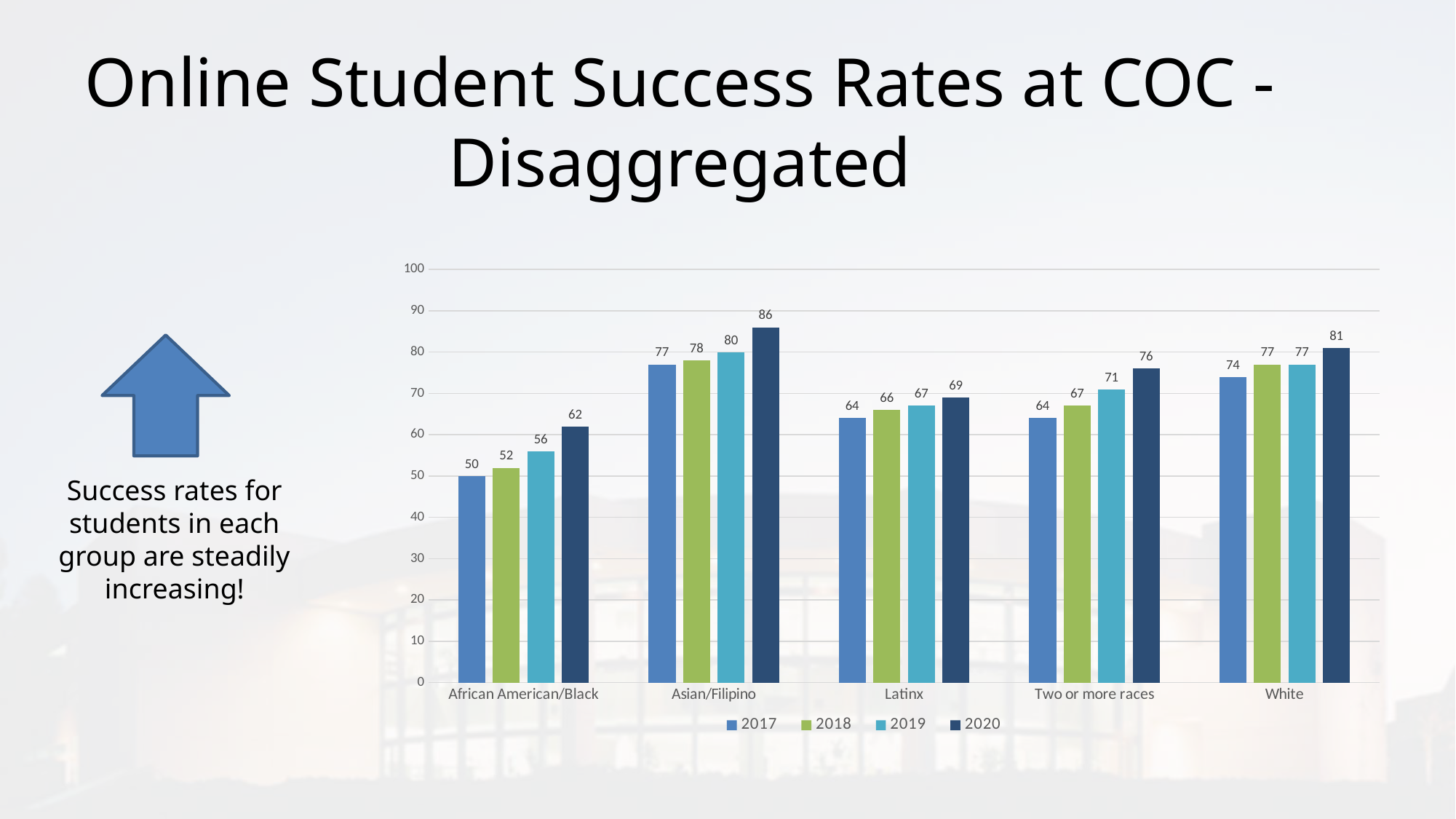
Do the values for White rise or fall from 2017 to 2020? Rise What is the difference between the 2020 and 2017 values for African American/Black? 12 How many categories are shown on the x axis? 5 What is the 2020 value for Asian/Filipino? 86 How many series does the legend list? 4 What is the 2017 value for African American/Black? 50 Which is larger, the 2018 value for Latinx or the 2018 value for Two or more races? Two or more races What kind of chart is shown on the slide? Bar chart Which category has the lowest 2017 value? African American/Black Which years are listed in the legend? 2017, 2018, 2019, 2020 What is the 2019 value for Two or more races? 71 Which category has the highest 2020 value? Asian/Filipino